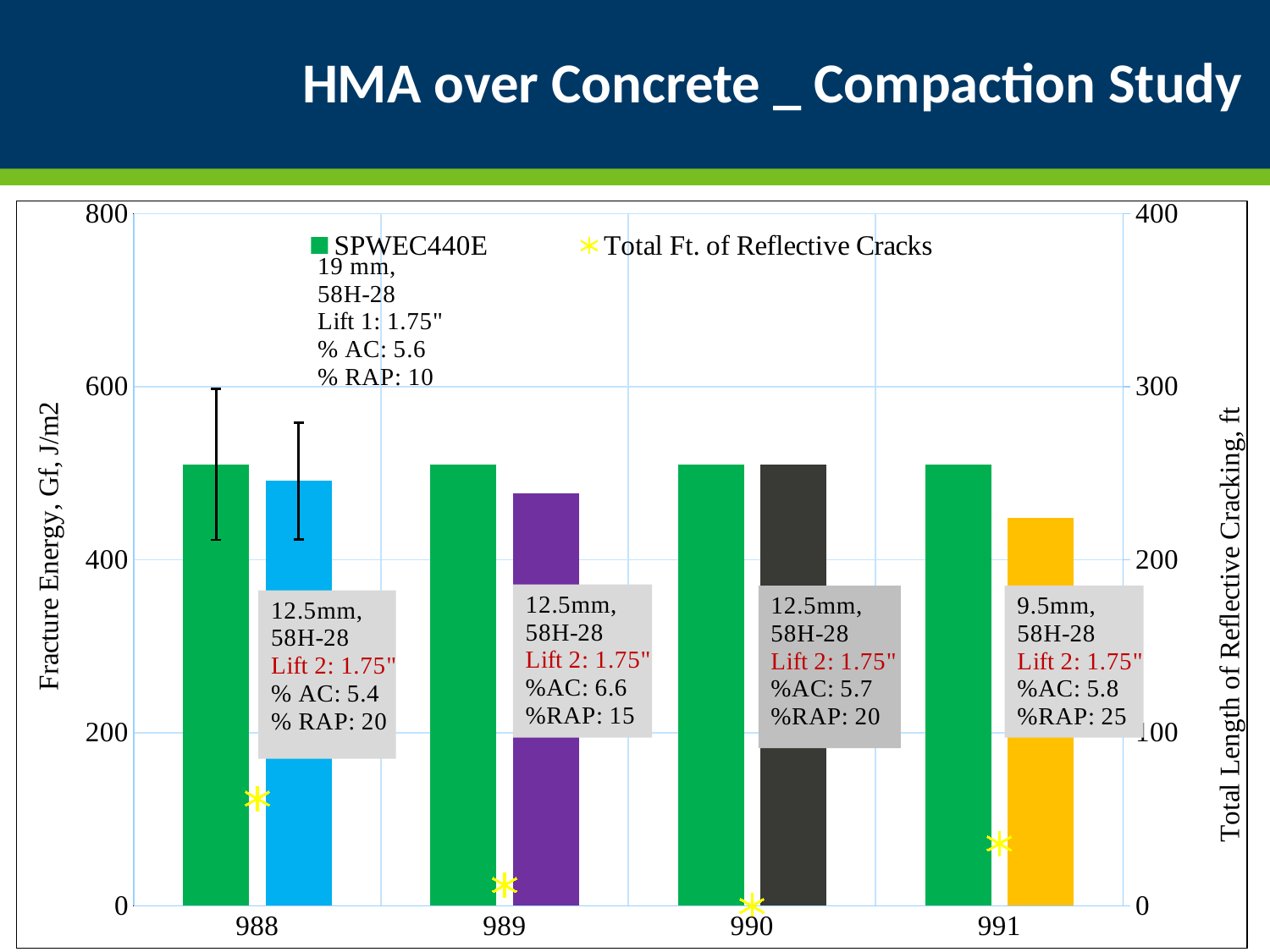
Is the fracture energy value of the purple bar for 989 greater or less than 400? greater Which category has the highest Total Ft. of Reflective Cracks value? 988 How many series does the legend list? 2 How many categories are shown on the x axis? 4 What kind of chart is shown on the slide? bar chart Is the fracture energy value of the yellow bar for 991 greater or less than 600? less Which has a higher Total Ft. of Reflective Cracks value, 988 or 989? 988 What is the title of the right vertical axis? Total Length of Reflective Cracking, ft What is the title of the left vertical axis? Fracture Energy, Gf, J/m2 Is the SPWEC440E fracture energy value for 988 greater or less than 400? greater For 991, which bar is taller: the SPWEC440E bar or the yellow bar? SPWEC440E